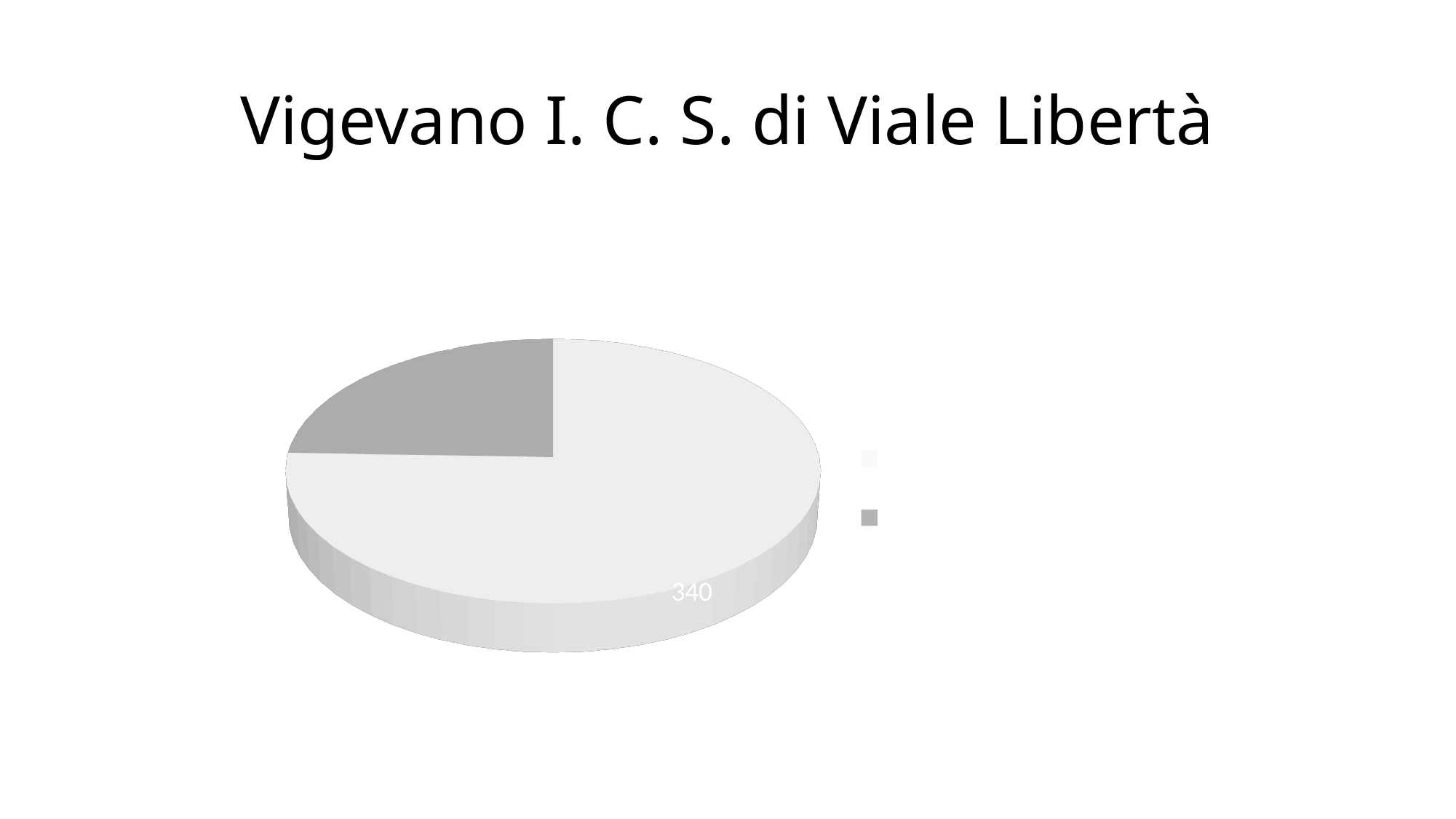
What kind of chart is shown on the slide? pie chart What value is printed on the largest slice of the pie chart? 340 How many entries does the legend list? 2 What is the title of the slide? Vigevano I. C. S. di Viale Libertà How many slices does the pie chart have? 2 Which slice of the pie chart is the smallest, the light grey one or the dark grey one? the dark grey one Does the light grey slice take up more or less than half of the pie? more Which slice of the pie chart is the largest, the light grey one or the dark grey one? the light grey one Is the light grey slice larger or smaller than the dark grey slice? larger